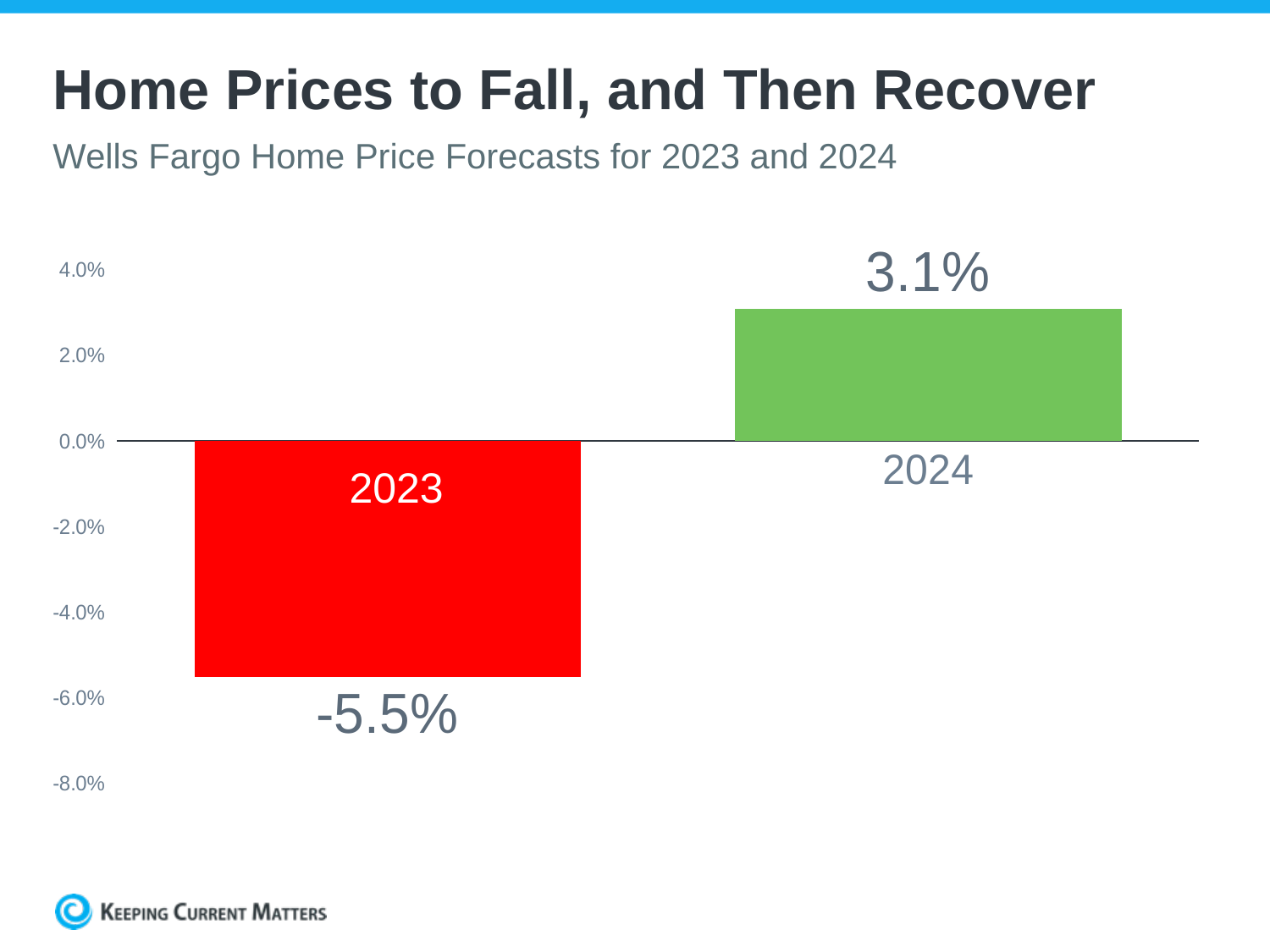
What is the subtitle of the chart? Wells Fargo Home Price Forecasts for 2023 and 2024 What colour is the bar for 2023? Red What is the forecast home price change for 2023? -5.5% What kind of chart is shown on the slide? Bar chart Do the forecast values rise or fall from 2023 to 2024? Rise Is the 2024 forecast value greater or less than 2.0%? greater What is the difference between the 2024 and 2023 forecast values? 8.6 percentage points Is the 2023 forecast value greater or less than -4.0%? less Which year has the higher forecast value? 2024 What is the forecast home price change for 2024? 3.1% Which year has the lowest forecast value? 2023 How many years are shown in the chart? 2